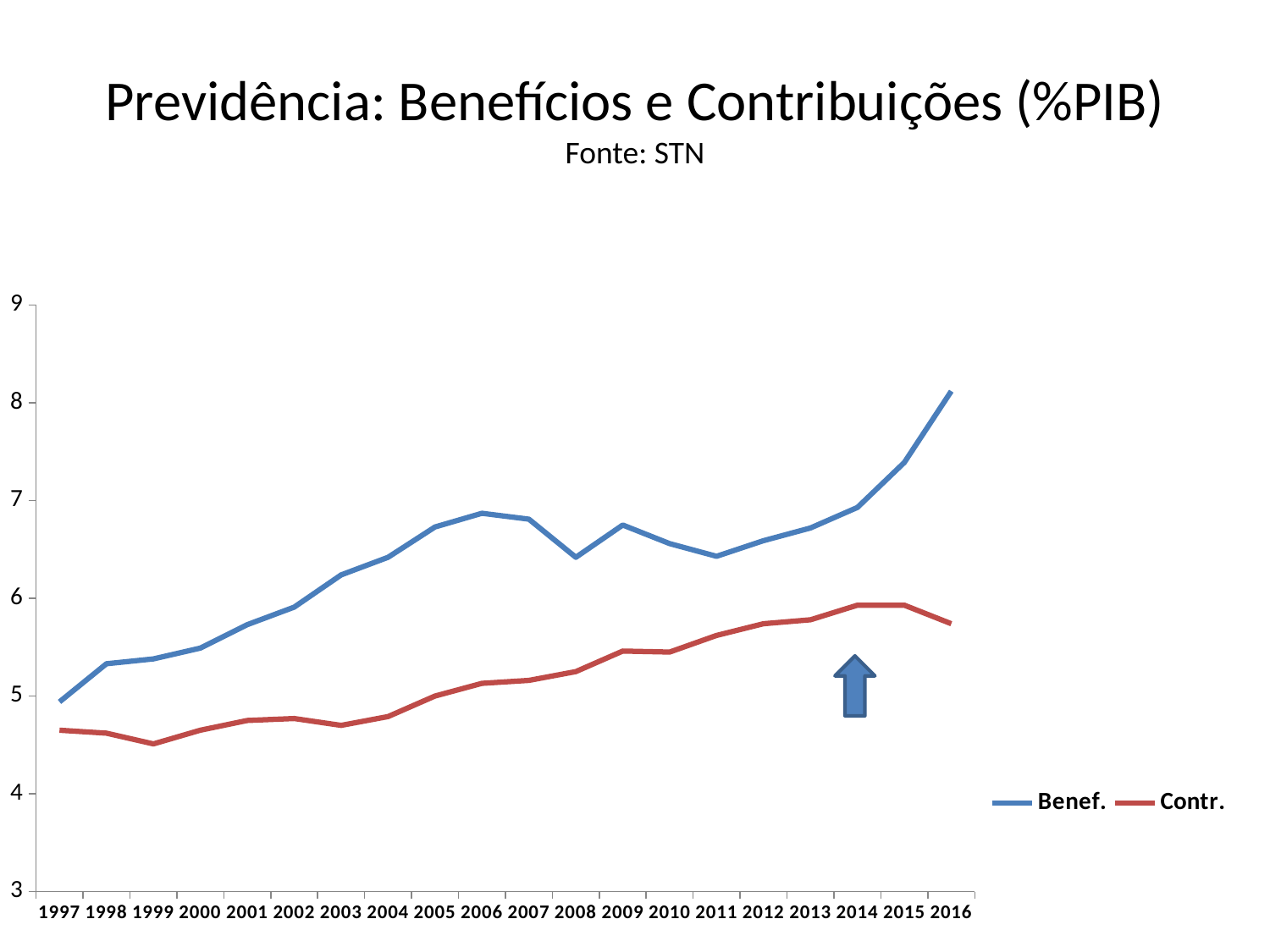
In which year is the Benef. series highest? 2016 How many series does the legend list? 2 What is the source cited under the chart title? STN What kind of chart is shown on the slide? line chart Is the value for Benef. in 2016 greater or less than 8? greater Which series does the blue line represent? Benef. Is the value for Benef. in 2008 greater or less than 6? greater Is the value for Contr. in 1999 greater or less than 5? less How many years are shown on the x axis? 20 In which year is the Contr. series lowest? 1999 In which year is the Benef. series lowest? 1997 In 2016, which series has the larger value, Benef. or Contr.? Benef.